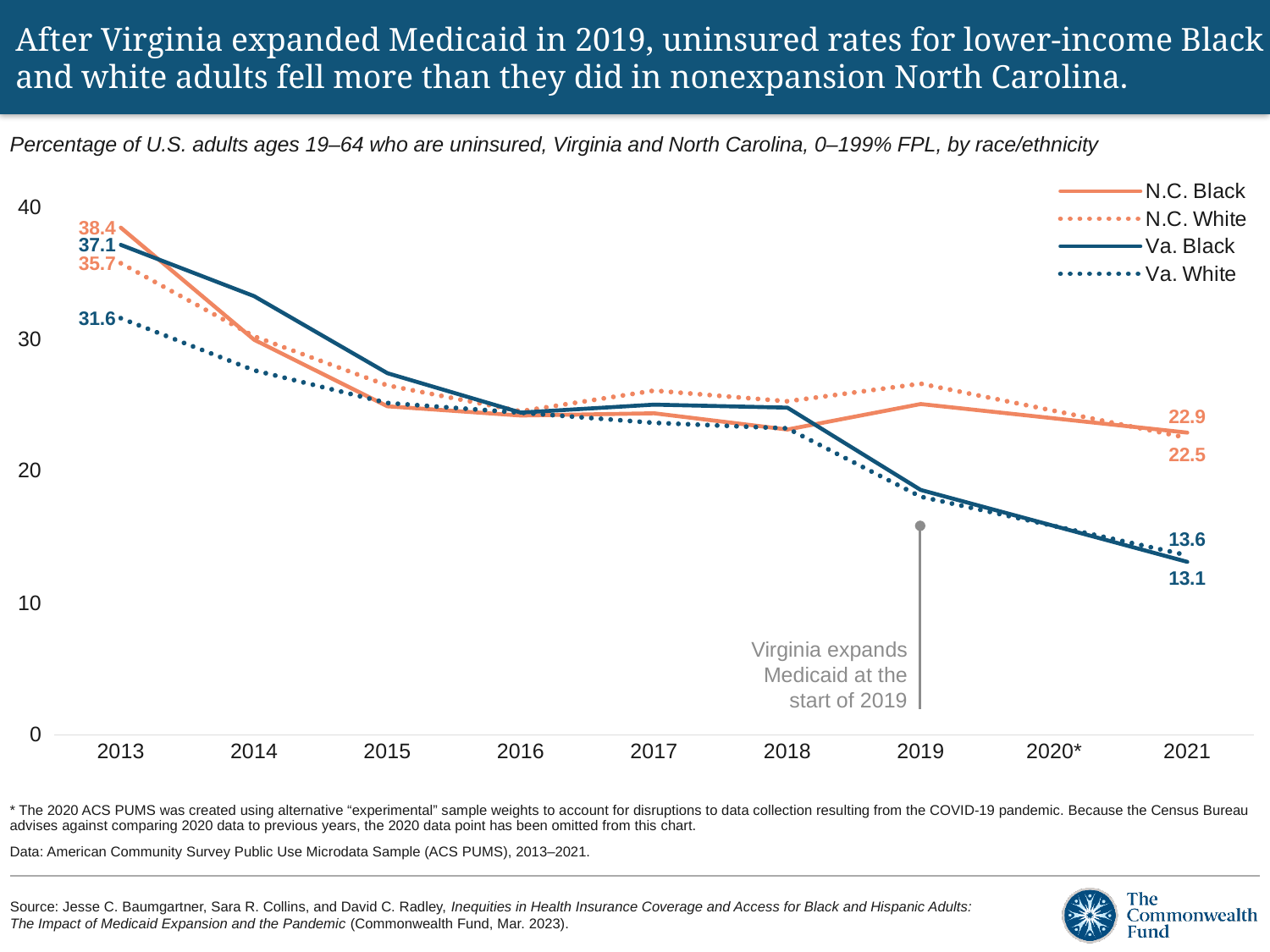
In 2021, which had the higher uninsured rate: N.C. White or Va. White? N.C. White Is the uninsured rate for Va. Black adults in 2019 greater or less than 20? less Which group had the lowest uninsured rate in 2021? Va. Black What was the uninsured rate for N.C. White adults in 2021? 22.5 Which group had the highest uninsured rate in 2013? N.C. Black What was the uninsured rate for Va. Black adults in 2021? 13.1 What kind of chart is shown on the slide? line chart How many series does the legend list? 4 By how many percentage points did the uninsured rate for N.C. Black adults fall from 2013 to 2021? 15.5 What was the uninsured rate for N.C. Black adults in 2013? 38.4 By how many percentage points did the uninsured rate for Va. Black adults fall from 2013 to 2021? 24.0 What was the uninsured rate for Va. White adults in 2013? 31.6